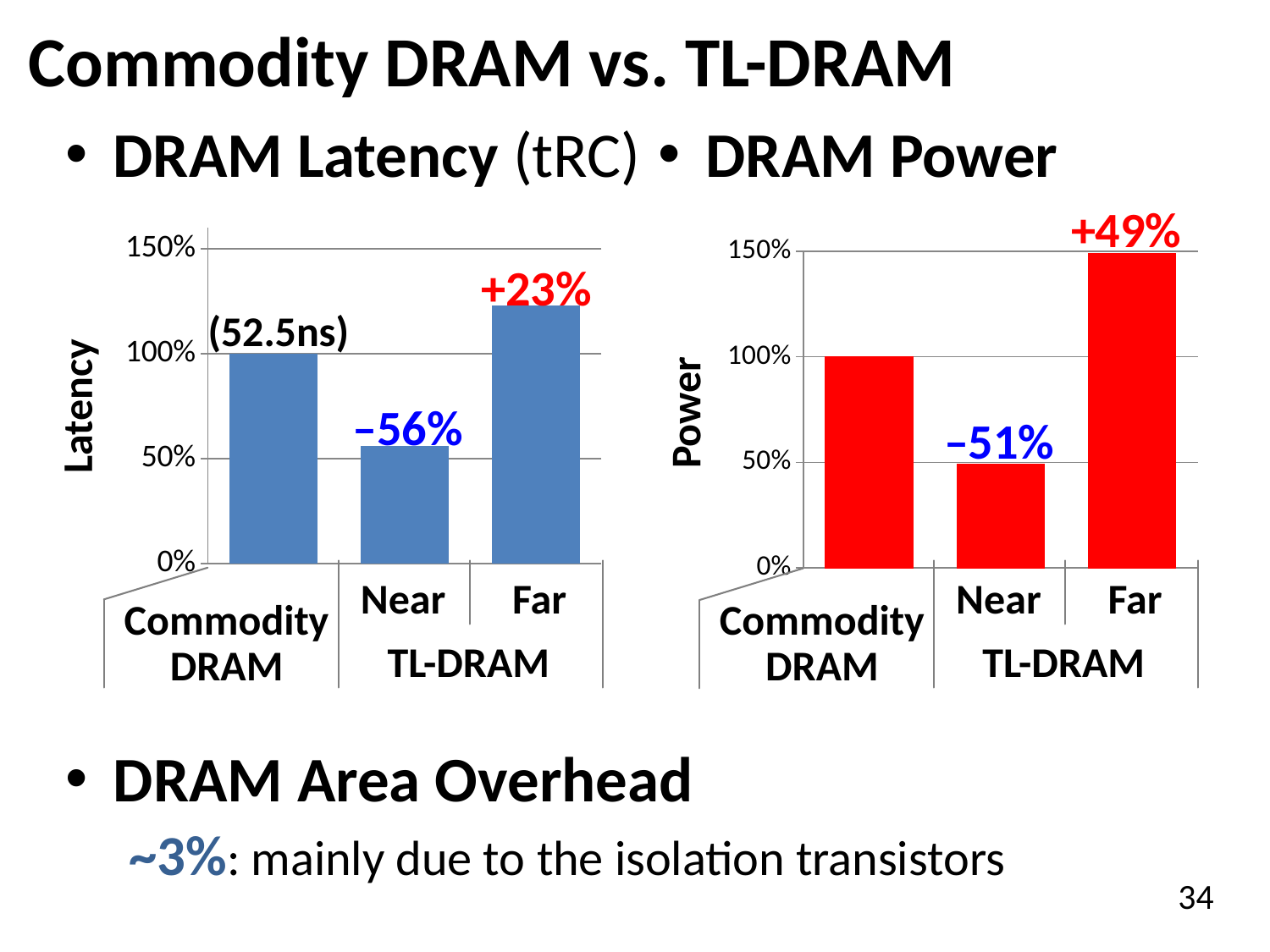
In the DRAM Power chart, which bar is the highest? TL-DRAM Far In the DRAM Latency chart, how many bars are plotted? 3 In the DRAM Latency chart, what percentage change is labelled above the TL-DRAM Near bar? –56% In the DRAM Power chart, is the value for TL-DRAM Far greater or less than 100%? greater In the DRAM Latency chart, what absolute latency is noted for Commodity DRAM? 52.5ns In the DRAM Latency chart, what kind of chart is shown? bar chart In the DRAM Latency chart, what percentage change is labelled above the TL-DRAM Far bar? +23% In the DRAM Latency chart, what value does the Commodity DRAM bar reach? 100% In the DRAM Power chart, how many bars are plotted? 3 In the DRAM Power chart, what percentage change is labelled above the TL-DRAM Near bar? –51% In the DRAM Power chart, what percentage change is labelled above the TL-DRAM Far bar? +49% In the DRAM Latency chart, which bar is the lowest? TL-DRAM Near